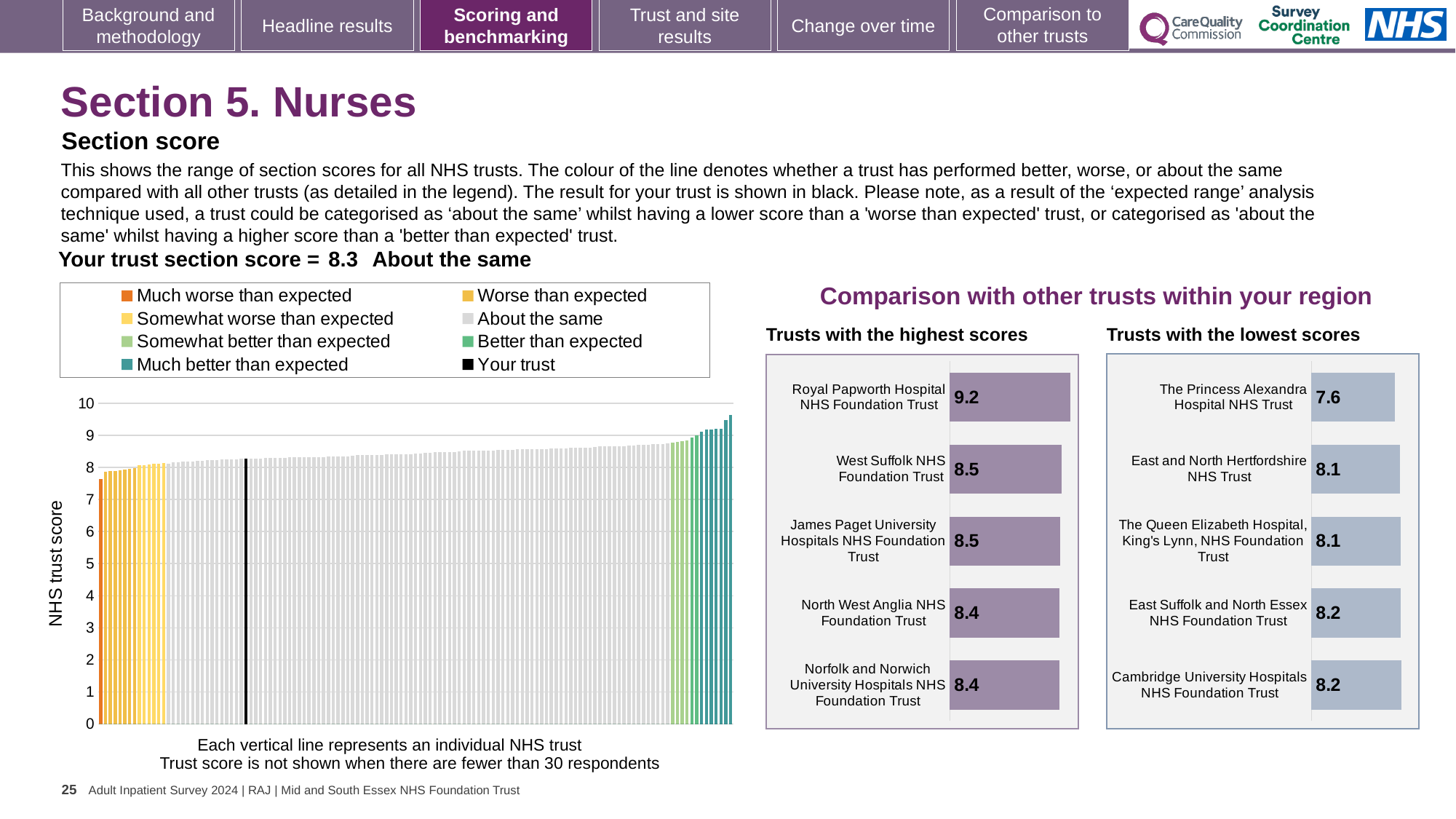
In the 'Trusts with the highest scores' chart, which trust has the highest score? Royal Papworth Hospital NHS Foundation Trust In the large chart on the left showing the range of section scores, what is the section score for your trust (the black line)? 8.3 In the 'Trusts with the highest scores' chart, what is the difference between the scores of Royal Papworth Hospital NHS Foundation Trust and Norfolk and Norwich University Hospitals NHS Foundation Trust? 0.8 How many trusts are shown in the 'Trusts with the highest scores' chart? 5 In the 'Trusts with the lowest scores' chart, what is the difference between the scores of East Suffolk and North Essex NHS Foundation Trust and The Princess Alexandra Hospital NHS Trust? 0.6 How many entries does the legend of the large chart on the left list? 8 In the 'Trusts with the lowest scores' chart, which has the larger score: Cambridge University Hospitals NHS Foundation Trust or The Princess Alexandra Hospital NHS Trust? Cambridge University Hospitals NHS Foundation Trust In the 'Trusts with the highest scores' chart, what is the score for Royal Papworth Hospital NHS Foundation Trust? 9.2 In the 'Trusts with the lowest scores' chart, which trust has the lowest score? The Princess Alexandra Hospital NHS Trust In the 'Trusts with the lowest scores' chart, what is the score for The Princess Alexandra Hospital NHS Trust? 7.6 In the large chart on the left, is the value of the highest (rightmost) trust bar greater or less than 9? greater In the large chart on the left, is the value of the lowest (leftmost) trust bar greater or less than 8? less